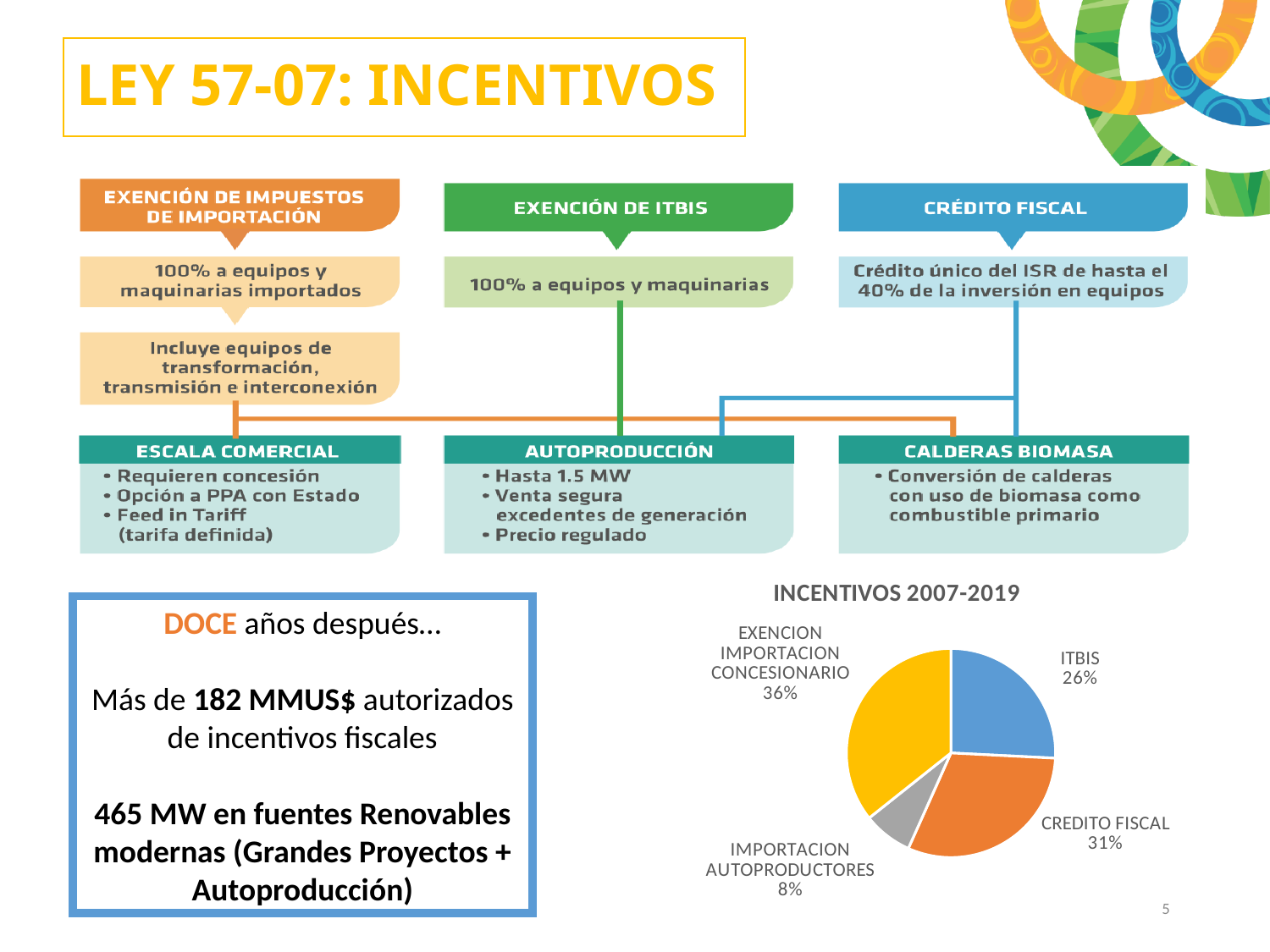
What is the share for ITBIS in the pie chart? 26% What is the difference in percentage points between CREDITO FISCAL and ITBIS in the pie chart? 5 Which category has the largest slice in the pie chart? EXENCION IMPORTACION CONCESIONARIO Which category has the smallest slice in the pie chart? IMPORTACION AUTOPRODUCTORES What type of chart is shown under the title 'INCENTIVOS 2007-2019'? pie chart What is the title of the pie chart? INCENTIVOS 2007-2019 What colour is the ITBIS slice in the pie chart? blue What is the share for EXENCION IMPORTACION CONCESIONARIO in the pie chart? 36% Which is larger in the pie chart, CREDITO FISCAL or ITBIS? CREDITO FISCAL What is the share for IMPORTACION AUTOPRODUCTORES in the pie chart? 8% How many slices does the pie chart have? 4 What is the share for CREDITO FISCAL in the pie chart? 31%